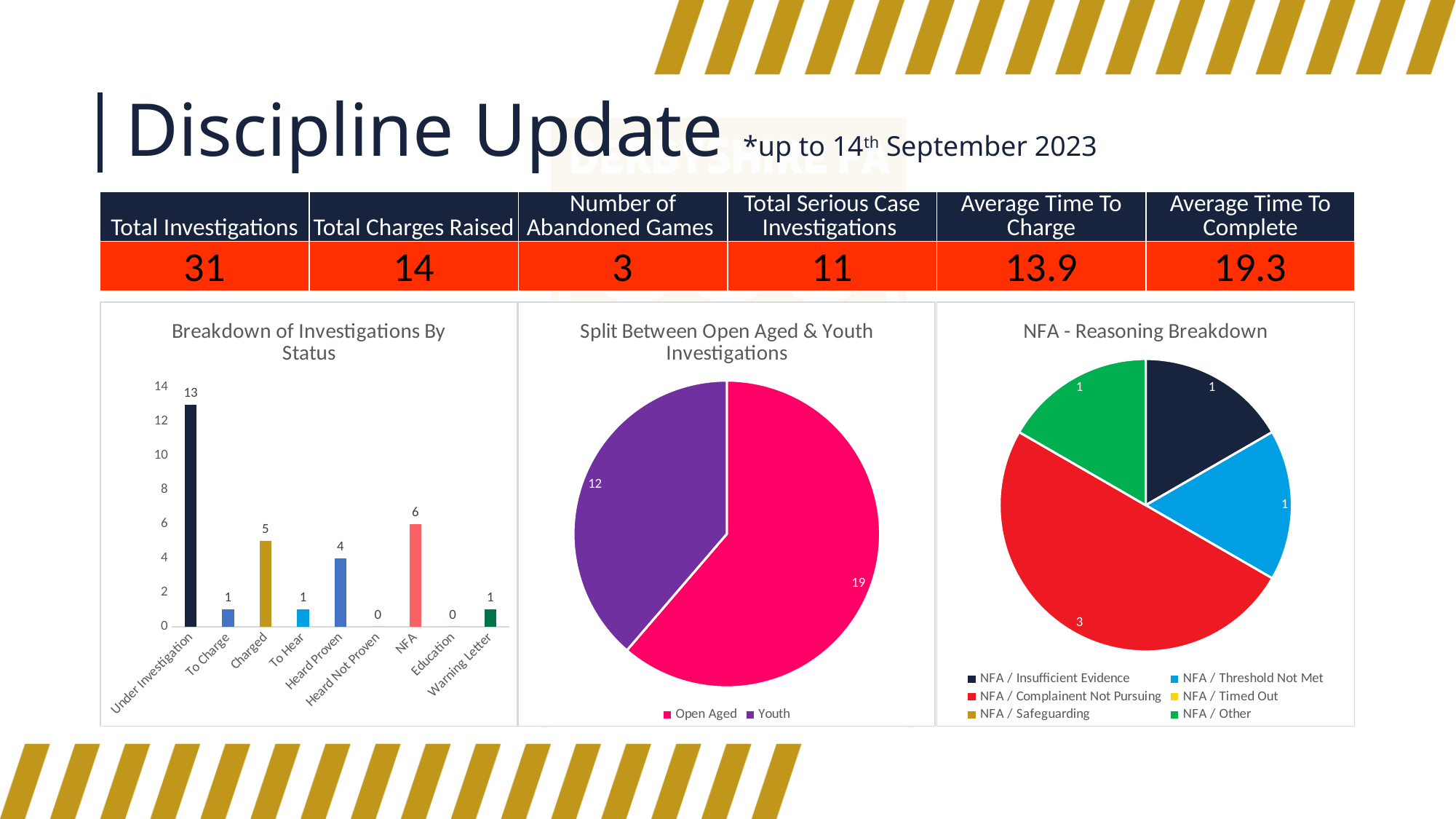
In the 'Breakdown of Investigations By Status' chart, what is the value for Under Investigation? 13 In the 'Split Between Open Aged & Youth Investigations' chart, what is the value for Open Aged? 19 How many entries does the legend of the 'NFA - Reasoning Breakdown' chart list? 6 What kind of chart is 'Breakdown of Investigations By Status'? Bar chart In the 'Breakdown of Investigations By Status' chart, what is the value for NFA? 6 In the 'Breakdown of Investigations By Status' chart, which is larger, Charged or Heard Proven? Charged In the 'Breakdown of Investigations By Status' chart, which status has the highest value? Under Investigation In the 'NFA - Reasoning Breakdown' chart, which reason has the largest slice? NFA / Complainent Not Pursuing In the 'Split Between Open Aged & Youth Investigations' chart, what is the difference between Open Aged and Youth? 7 In the 'Breakdown of Investigations By Status' chart, what is the difference between the Under Investigation and NFA values? 7 How many status categories are shown in the 'Breakdown of Investigations By Status' chart? 9 In the 'Split Between Open Aged & Youth Investigations' chart, what is the total of the two slices? 31